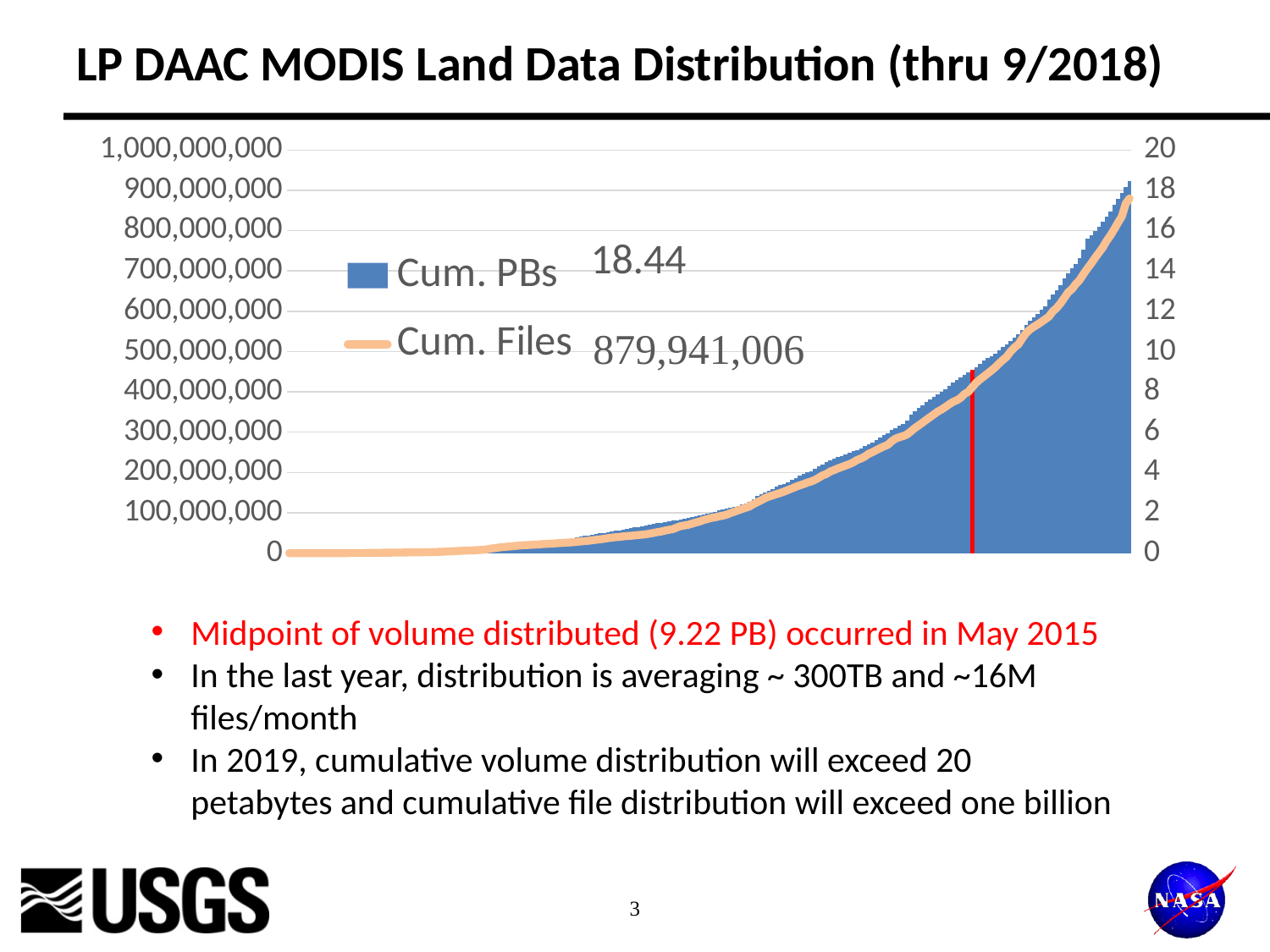
Do the values of the Cum. PBs series rise or fall along the x axis? rise What is the maximum value shown on the right-hand vertical axis? 20 How many series does the chart's legend list? 2 Do the values of the Cum. Files series rise or fall along the x axis? rise What is the final cumulative value labelled for the Cum. Files series? 879,941,006 Is the final value of the Cum. Files series greater or less than 800,000,000? greater What is the final cumulative value labelled for the Cum. PBs series? 18.44 Which series is drawn as a line rather than as bars? Cum. Files What are the two series named in the legend? Cum. PBs and Cum. Files What is the title of the chart? LP DAAC MODIS Land Data Distribution (thru 9/2018) Is the final value of the Cum. Files series greater or less than 1,000,000,000? less Is the final value of the Cum. PBs series greater or less than 18? greater